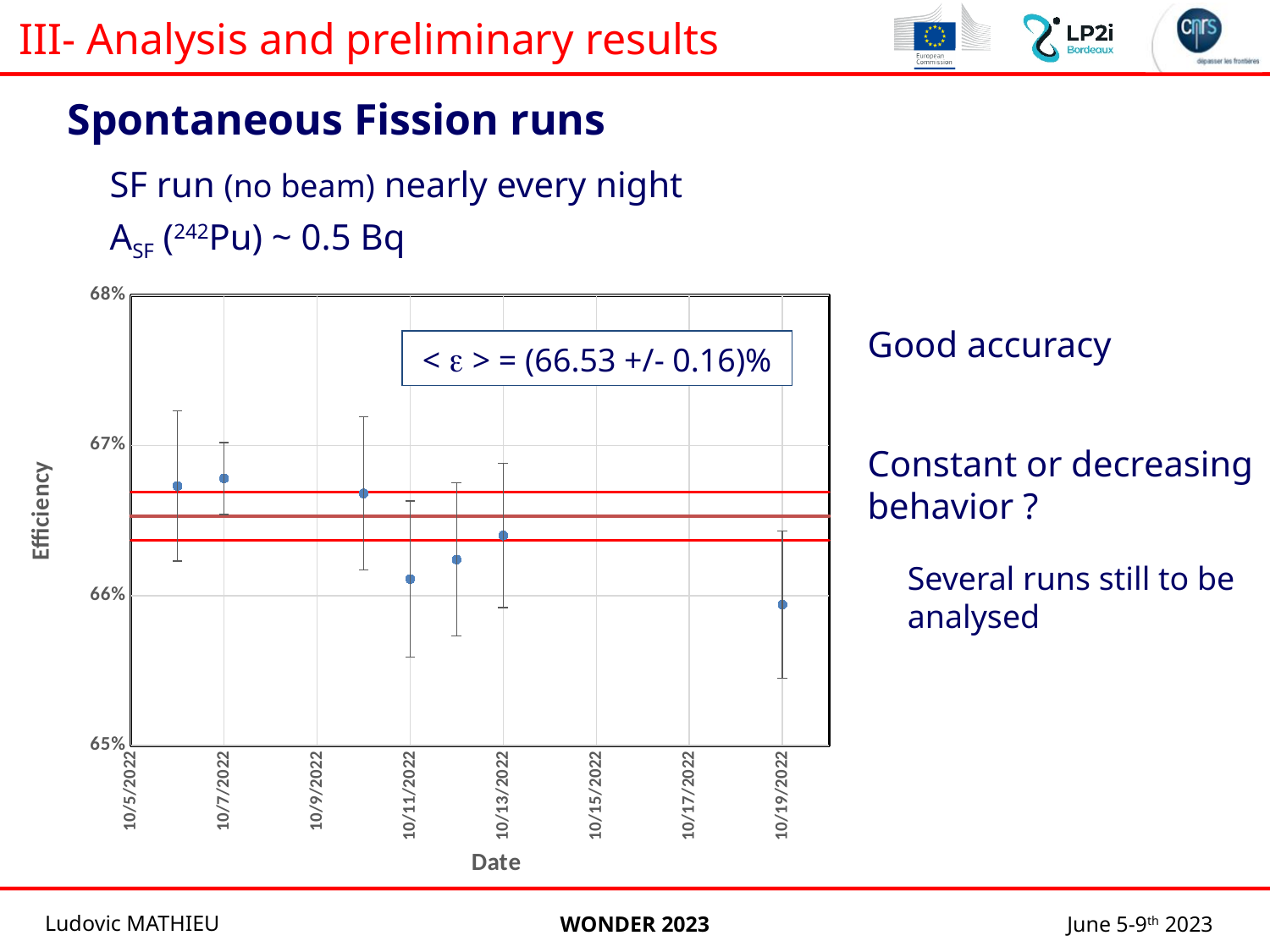
Is the efficiency value for 10/13/2022 greater or less than 66%? greater What is the title of the y axis of the chart? Efficiency Is the efficiency value for 10/7/2022 greater or less than 67%? less How many data points are plotted on the chart? 7 What is the title of the x axis of the chart? Date What kind of chart is shown on the slide? scatter chart What mean efficiency value is printed in the box on the chart? (66.53 +/- 0.16)% Which has the larger efficiency value, 10/7/2022 or 10/19/2022? 10/7/2022 What is the lowest value shown on the y axis of the chart? 65% Do the efficiency values generally rise or fall along the date axis? fall Which date has the lowest plotted efficiency? 10/19/2022 Is the efficiency value for 10/7/2022 greater or less than 66%? greater